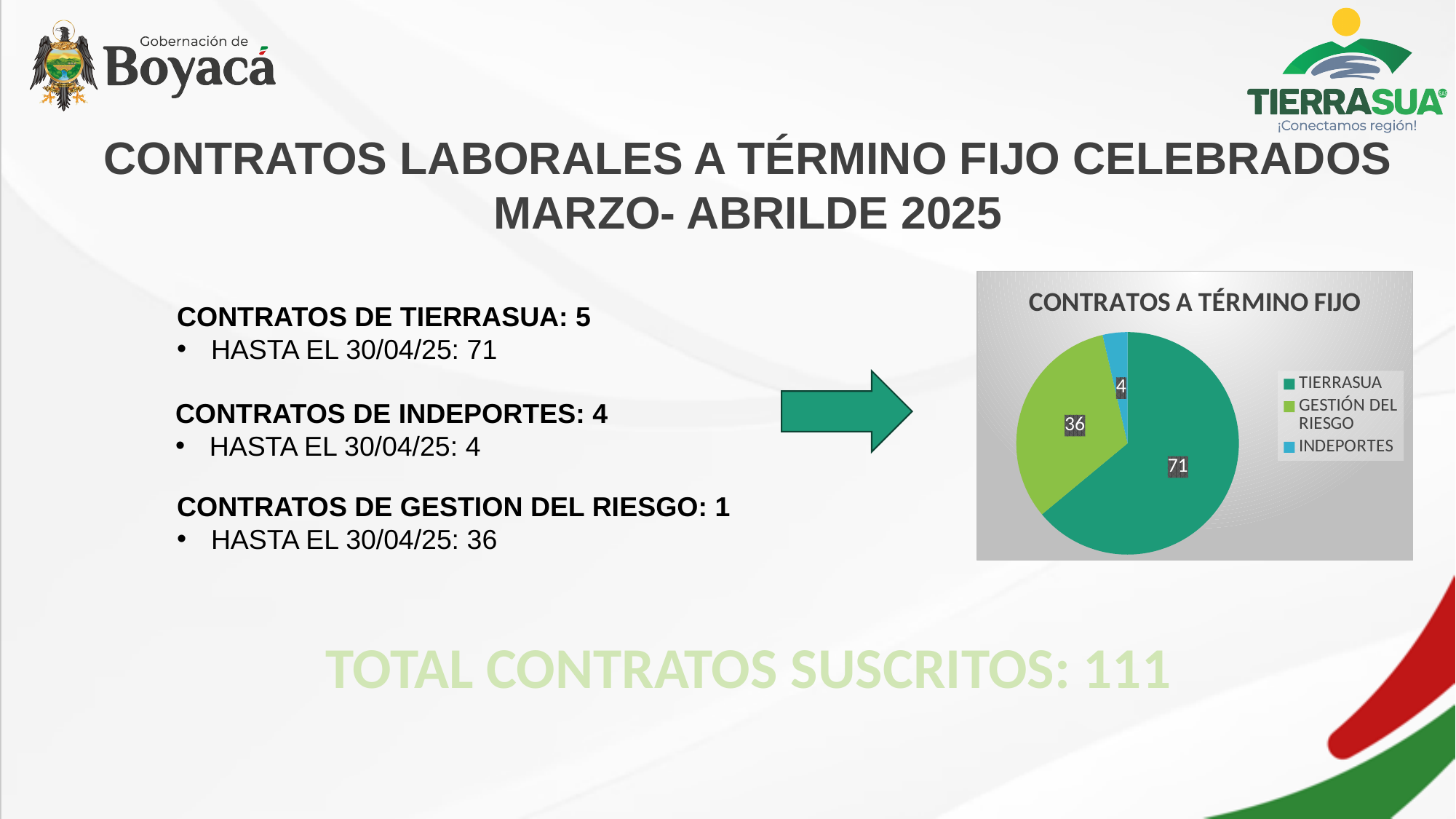
What is the total of all the slices in the pie chart? 111 What value is shown for INDEPORTES in the pie chart? 4 What type of chart is shown on the slide? Pie chart How many categories does the pie chart show? 3 Which category has the largest slice in the pie chart? TIERRASUA What is the difference between the TIERRASUA value and the GESTIÓN DEL RIESGO value? 35 What value is shown for TIERRASUA in the pie chart? 71 Which category has the smallest slice in the pie chart? INDEPORTES What value is shown for GESTIÓN DEL RIESGO in the pie chart? 36 To the nearest whole percent, what share of the pie does TIERRASUA represent? 64% Which is larger, the value for GESTIÓN DEL RIESGO or the value for INDEPORTES? GESTIÓN DEL RIESGO What is the title of the chart? CONTRATOS A TÉRMINO FIJO